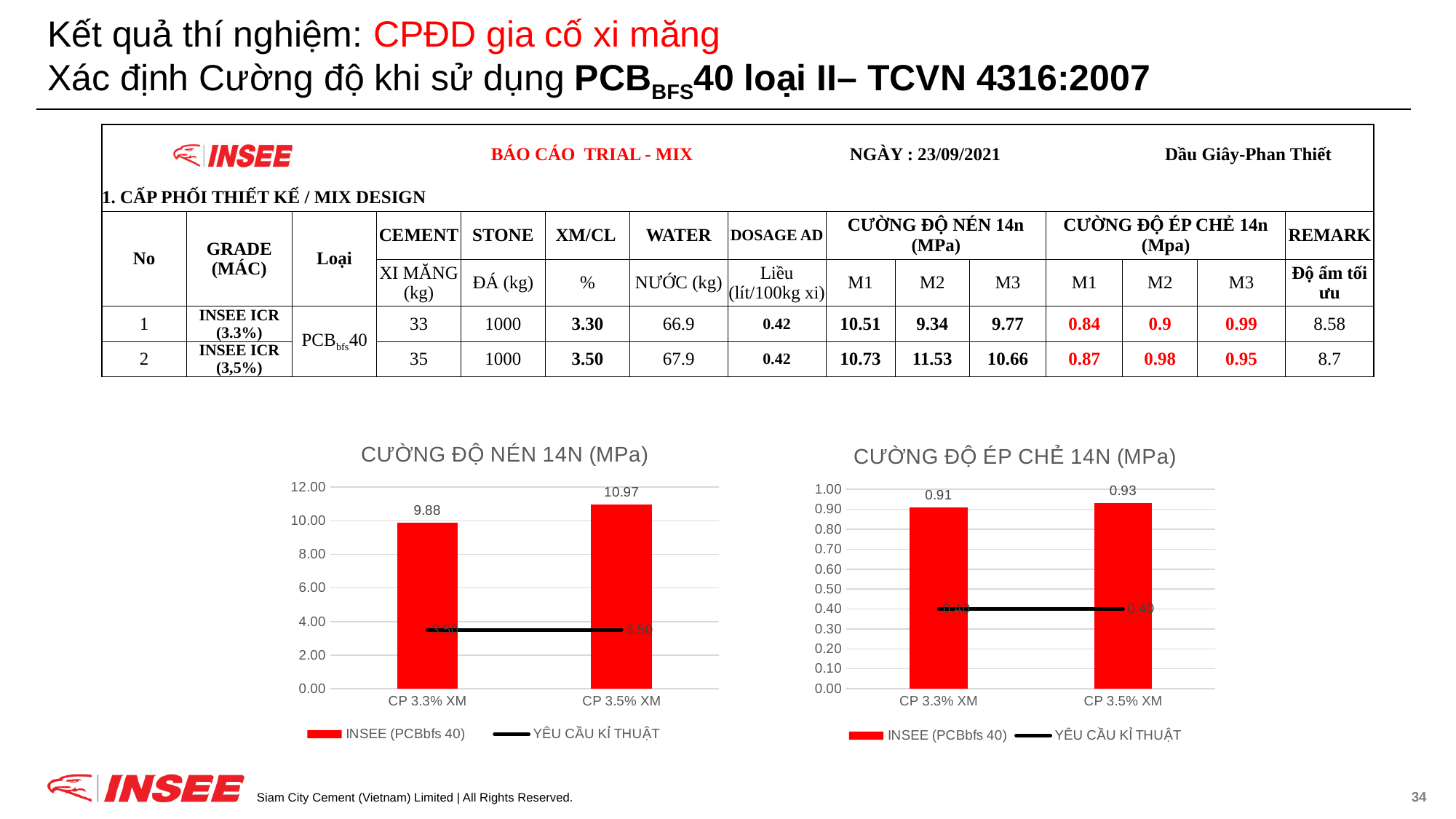
In the chart titled CƯỜNG ĐỘ NÉN 14N (MPa), is the INSEE (PCBbfs 40) value for CP 3.3% XM greater or less than 8.00? greater In the chart titled CƯỜNG ĐỘ NÉN 14N (MPa), what is the difference between the INSEE (PCBbfs 40) values for CP 3.5% XM and CP 3.3% XM? 1.09 How many categories are shown on the x axis of the chart titled CƯỜNG ĐỘ NÉN 14N (MPa)? 2 In the chart titled CƯỜNG ĐỘ ÉP CHẺ 14N (MPa), what is the YÊU CẦU KỈ THUẬT value for CP 3.3% XM? 0.40 In the chart titled CƯỜNG ĐỘ ÉP CHẺ 14N (MPa), what is the INSEE (PCBbfs 40) value for CP 3.5% XM? 0.93 In the chart titled CƯỜNG ĐỘ NÉN 14N (MPa), what is the INSEE (PCBbfs 40) value for CP 3.5% XM? 10.97 In the chart titled CƯỜNG ĐỘ NÉN 14N (MPa), what is the YÊU CẦU KỈ THUẬT value for CP 3.5% XM? 3.50 In the chart titled CƯỜNG ĐỘ NÉN 14N (MPa), which category has the higher INSEE (PCBbfs 40) bar? CP 3.5% XM In the chart titled CƯỜNG ĐỘ NÉN 14N (MPa), what is the INSEE (PCBbfs 40) value for CP 3.3% XM? 9.88 In the chart titled CƯỜNG ĐỘ ÉP CHẺ 14N (MPa), what is the INSEE (PCBbfs 40) value for CP 3.3% XM? 0.91 How many series does the legend of the chart titled CƯỜNG ĐỘ ÉP CHẺ 14N (MPa) list? 2 In the chart titled CƯỜNG ĐỘ ÉP CHẺ 14N (MPa), what is the difference between the INSEE (PCBbfs 40) values for CP 3.5% XM and CP 3.3% XM? 0.02